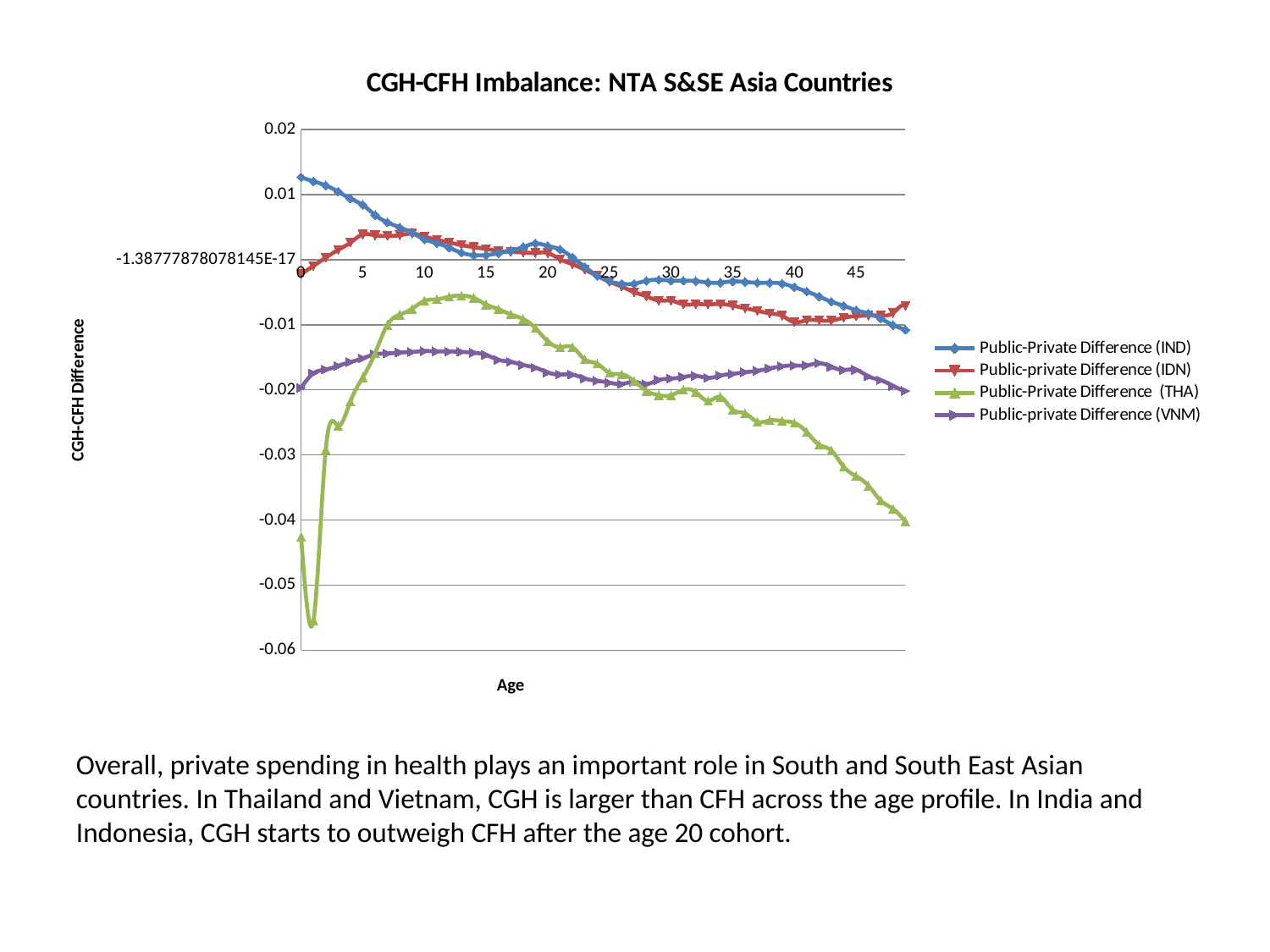
Is the value for Public-Private Difference (IND) at age 0 greater or less than 0.01? greater Does the Public-Private Difference (IND) series generally rise or fall from age 0 to age 45? fall What is the title of the chart? CGH-CFH Imbalance: NTA S&SE Asia Countries Is the value for Public-private Difference (VNM) at age 0 greater or less than -0.01? less At age 45, which is larger: Public-private Difference (IDN) or Public-Private Difference (THA)? Public-private Difference (IDN) What is the label on the vertical axis of the chart? CGH-CFH Difference How many series does the legend list? 4 Is the value for Public-Private Difference (THA) at age 45 greater or less than -0.03? less Which series reaches the lowest value anywhere on the chart? Public-Private Difference (THA) Which series has the lowest value at age 0? Public-Private Difference (THA) Which series has the highest value at age 0? Public-Private Difference (IND) What kind of chart is shown on the slide? line chart